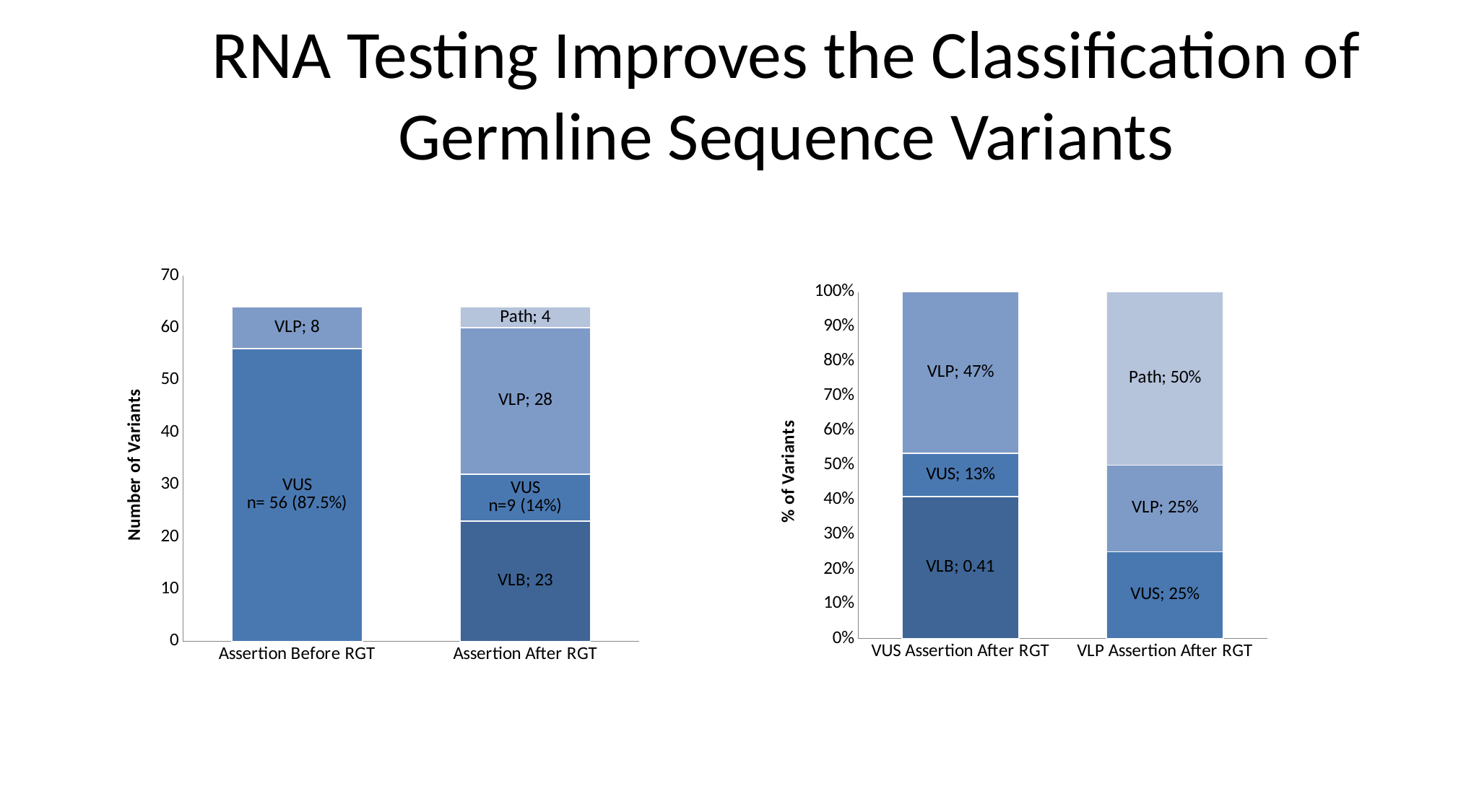
In the left chart, which segment of the Assertion After RGT bar is the largest? VLP In the right chart, what percentage of VUS Assertion After RGT is VLP? 47% In the left chart, how many categories are shown on the x axis? 2 In the left chart, what is the total number of variants in the Assertion After RGT bar? 64 In the left chart, what is the VUS label for Assertion Before RGT? n= 56 (87.5%) What type of chart is the right chart? Stacked bar chart In the left chart, how many VLP variants are shown for Assertion Before RGT? 8 In the right chart, what percentage of VLP Assertion After RGT is Path? 50% In the left chart, how many VLB variants are shown for Assertion After RGT? 23 In the right chart, which segment of the VUS Assertion After RGT bar is the smallest? VUS In the left chart, how many Path variants are shown for Assertion After RGT? 4 In the left chart, what is the difference between the VLP count after RGT and the VLP count before RGT? 20